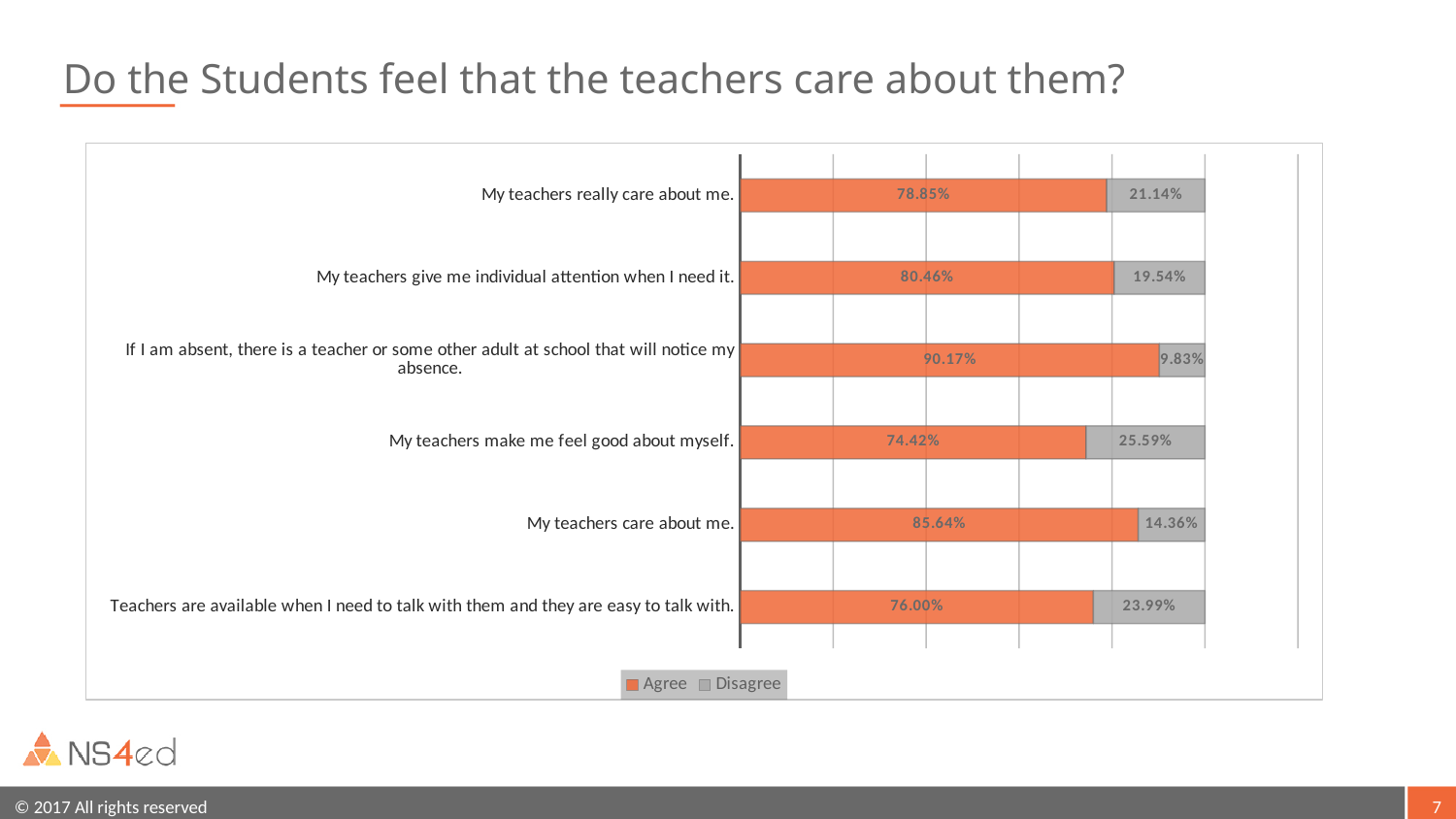
What is the difference in Agree percentage between "If I am absent, there is a teacher or some other adult at school that will notice my absence." and "My teachers make me feel good about myself."? 15.75 percentage points What is the Agree value for "Teachers are available when I need to talk with them and they are easy to talk with."? 76.00% Which statement has the lowest Agree percentage? My teachers make me feel good about myself. What percentage of students disagree with "My teachers make me feel good about myself."? 25.59% What percentage of students agree with "My teachers really care about me."? 78.85% What is the Disagree value for "My teachers give me individual attention when I need it."? 19.54% How many series does the legend list? 2 What is the total of the Agree and Disagree values for "My teachers care about me."? 100.00% How many statements are shown in the chart? 6 Which statement has the highest Agree percentage? If I am absent, there is a teacher or some other adult at school that will notice my absence. Which has a higher Agree percentage: "My teachers care about me." or "My teachers really care about me."? My teachers care about me. What type of chart is shown on the slide? Stacked bar chart